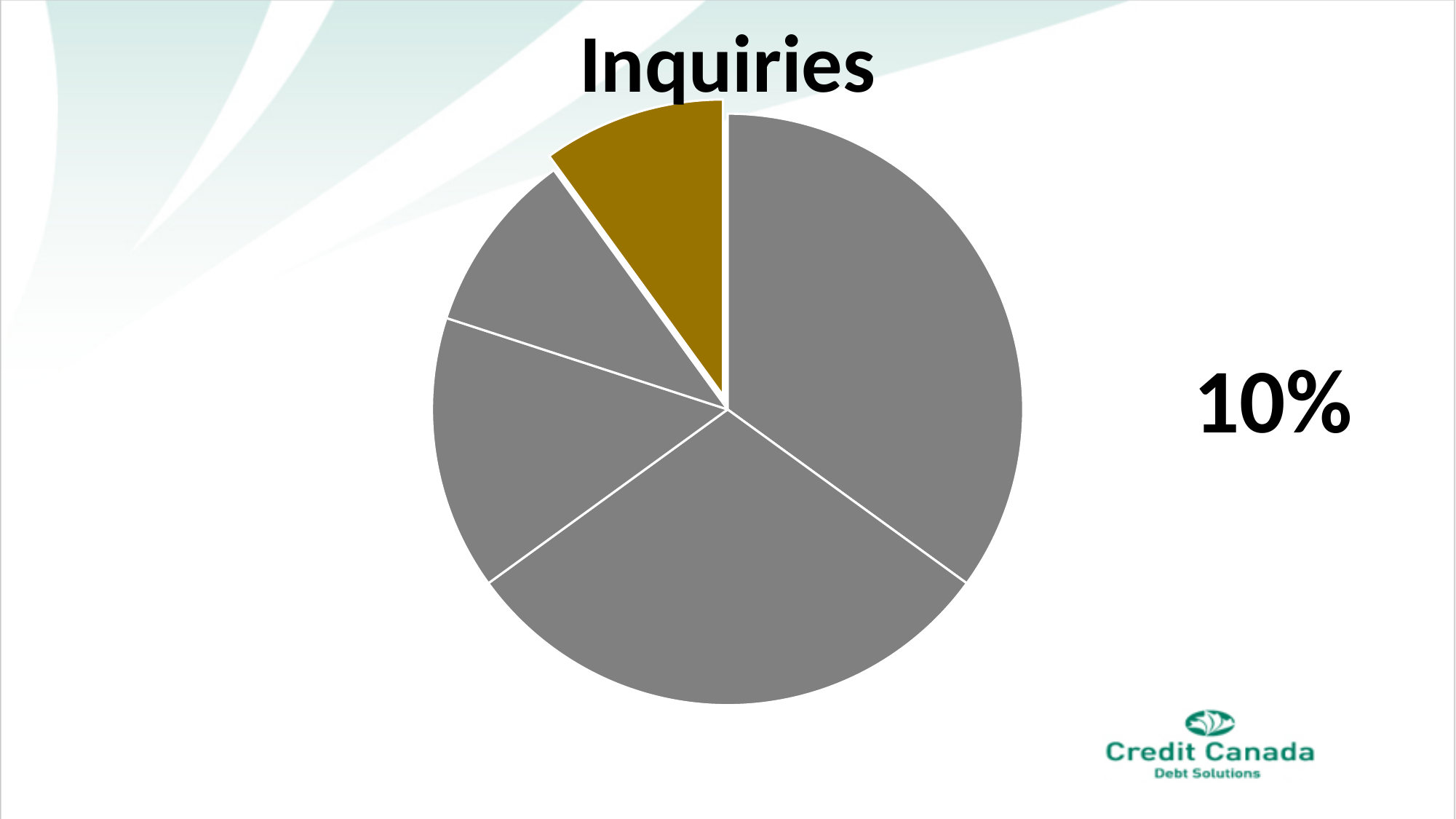
What colour is the exploded, highlighted slice of the pie chart? gold What kind of chart is shown on the slide? pie chart What share of the pie does the highlighted (gold) slice represent, according to the percentage shown on the slide? 10% Is the highlighted gold slice the largest slice of the pie? No What is the title of the chart? Inquiries How many slices does the pie chart have? 5 Is the highlighted gold slice's share greater or less than 50%? less